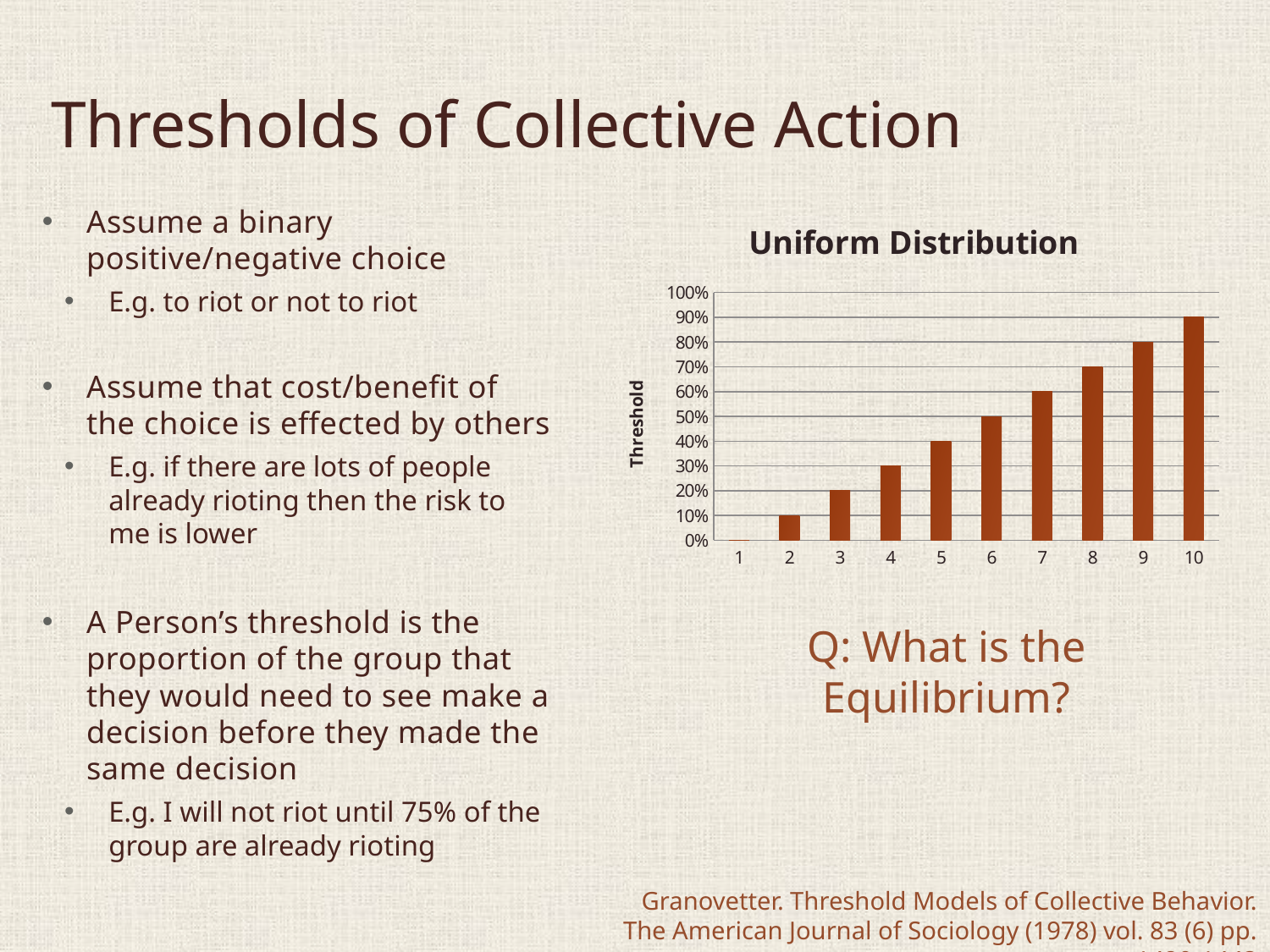
Which category has the lowest threshold value? 1 What kind of chart is shown on the slide? bar chart What is the title of the chart? Uniform Distribution Which category has the highest threshold value? 10 What is the threshold value for category 10? 90% What is the label of the vertical axis of the chart? Threshold What is the threshold value for category 2? 10% Which has a larger threshold value, category 4 or category 7? 7 Do the threshold values rise or fall as the category number increases from 1 to 10? rise How many categories are plotted on the x axis of the chart? 10 What is the difference between the threshold values for category 8 and category 3? 50% What is the threshold value for category 5? 40%